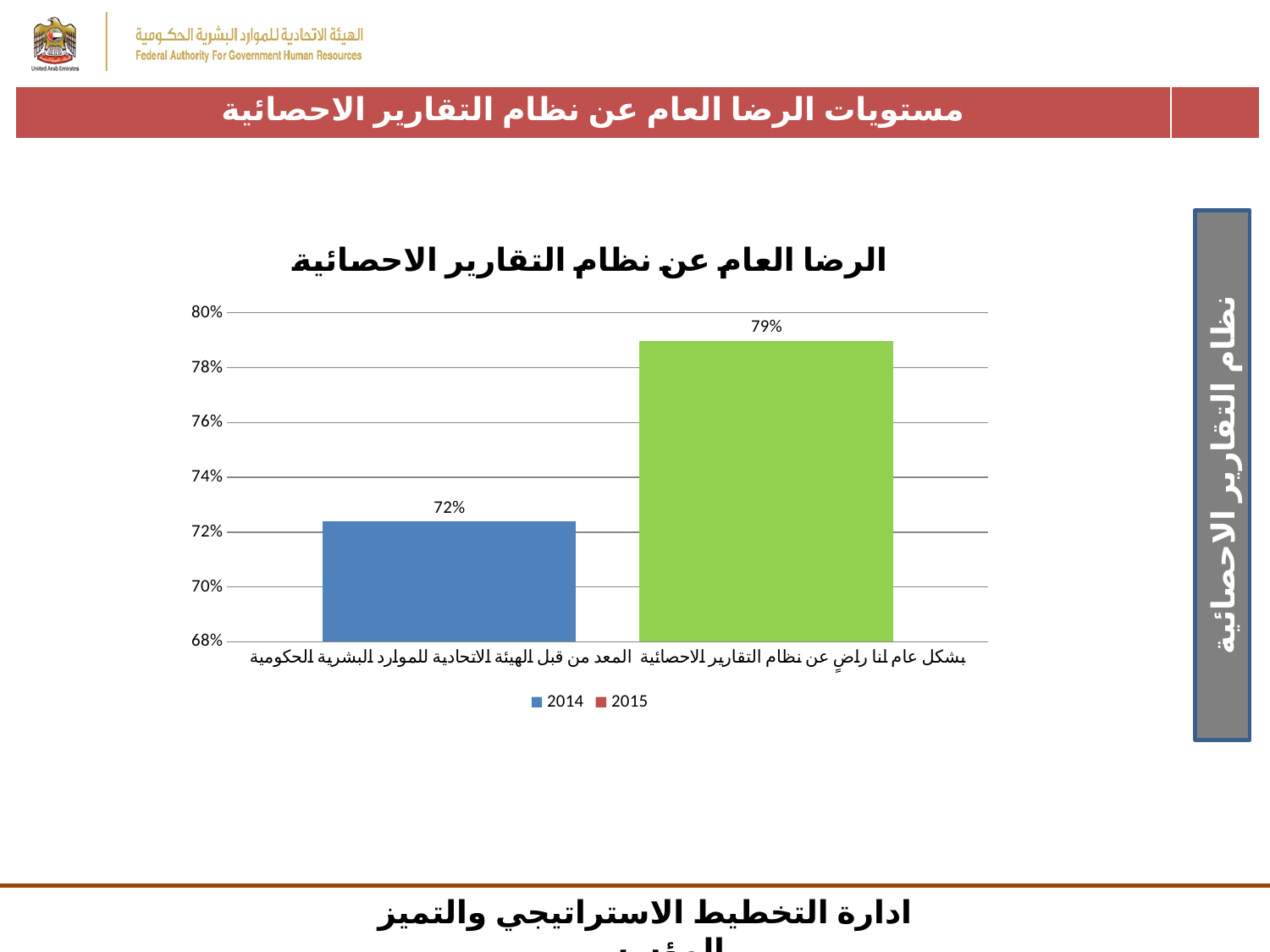
Is the value for 2015 greater or less than 78%? greater What is the title of the chart? الرضا العام عن نظام التقارير الاحصائية Which year has the lower value? 2014 What is the value for 2014? 72% Does the value rise or fall from 2014 to 2015? Rise Which year has the higher value? 2015 How many series does the legend list? 2 What is the value for 2015? 79% Is the value for 2015 larger than the value for 2014? Yes What is the difference between the 2015 value and the 2014 value? 7% Is the value for 2014 greater or less than 74%? less What kind of chart is shown on the slide? Bar chart